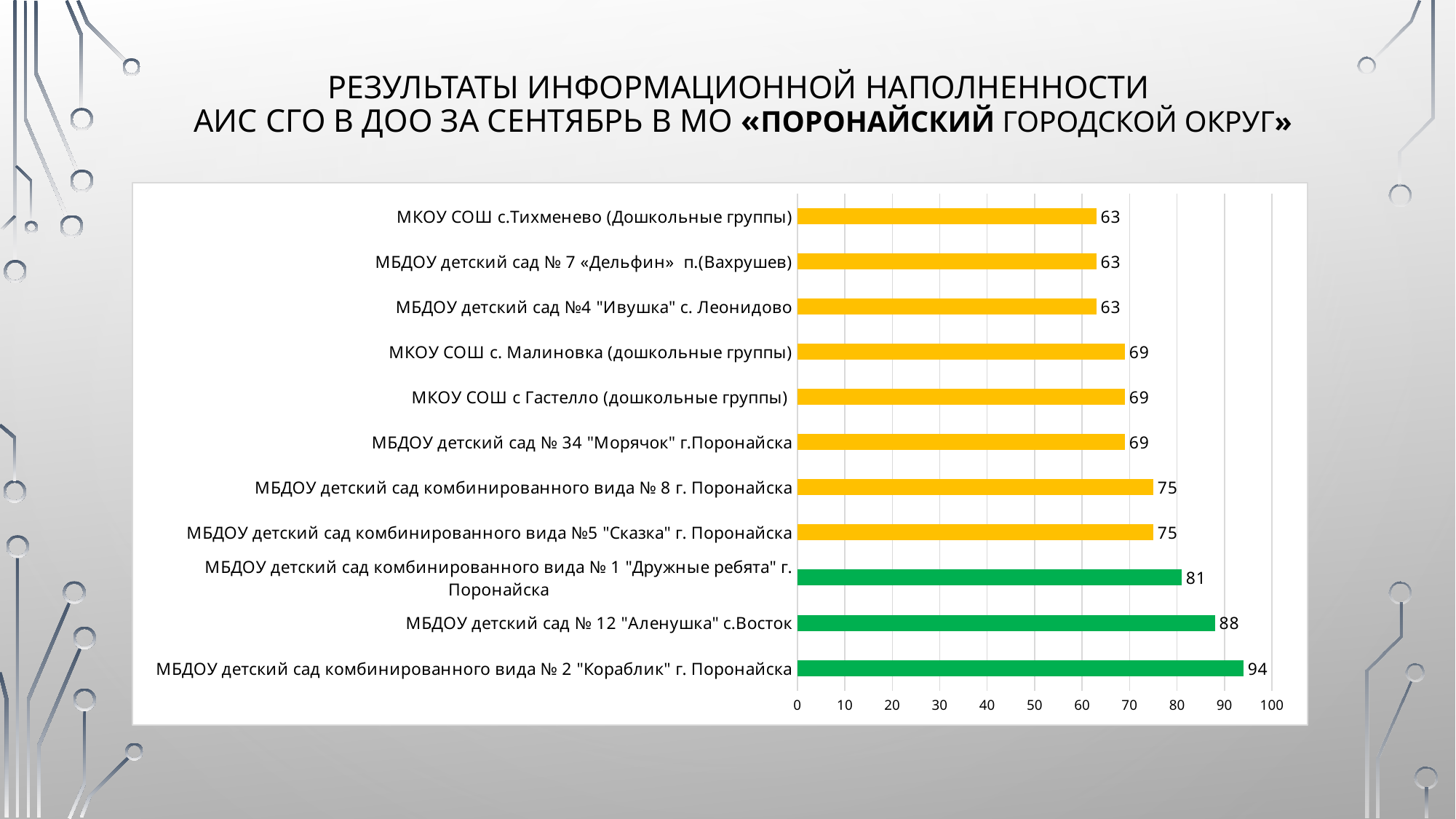
What is the value for МКОУ СОШ с. Малиновка (дошкольные группы)? 69 Is the value for МБДОУ детский сад №4 "Ивушка" с. Леонидово greater or less than 70? less Which has a larger value: МБДОУ детский сад комбинированного вида № 8 г. Поронайска or МКОУ СОШ с Гастелло (дошкольные группы)? МБДОУ детский сад комбинированного вида № 8 г. Поронайска What is the value for МБДОУ детский сад № 12 "Аленушка" с.Восток? 88 Which organisation has the highest value in the chart? МБДОУ детский сад комбинированного вида № 2 "Кораблик" г. Поронайска What is the value for МБДОУ детский сад комбинированного вида № 1 "Дружные ребята" г. Поронайска? 81 What is the difference between the values for МБДОУ детский сад № 12 "Аленушка" с.Восток and МБДОУ детский сад № 34 "Морячок" г.Поронайска? 19 How many organisations (categories) are plotted in the chart? 11 What colour are the bars for the three organisations with the highest values? green What is the lowest value shown in the chart? 63 What kind of chart is shown on the slide? bar chart What is the value for МБДОУ детский сад комбинированного вида № 2 "Кораблик" г. Поронайска? 94